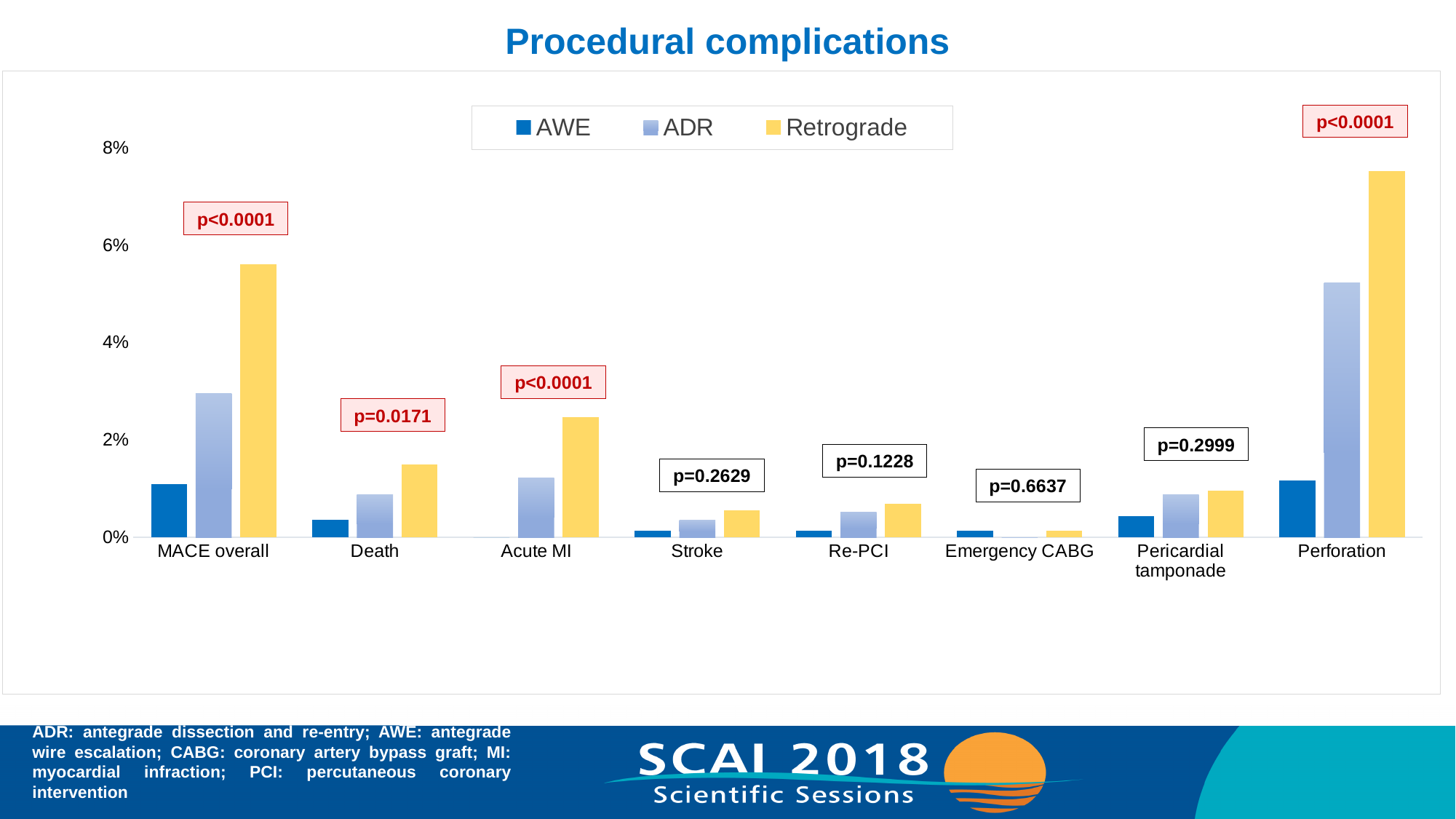
For Perforation, which is larger: the AWE value or the ADR value? ADR For MACE overall, which is larger: the ADR value or the Retrograde value? Retrograde Is the Retrograde value for MACE overall greater or less than 4%? greater How many series does the legend list? 3 What kind of chart is shown on the slide? bar chart Which category has the highest Retrograde value? Perforation Which series has the lowest value for Perforation? AWE Is the Retrograde value for Death greater or less than 2%? less How many complication categories are shown on the x axis? 8 Is the Retrograde value for Perforation greater or less than 6%? greater What p-value is shown above the Death category? p=0.0171